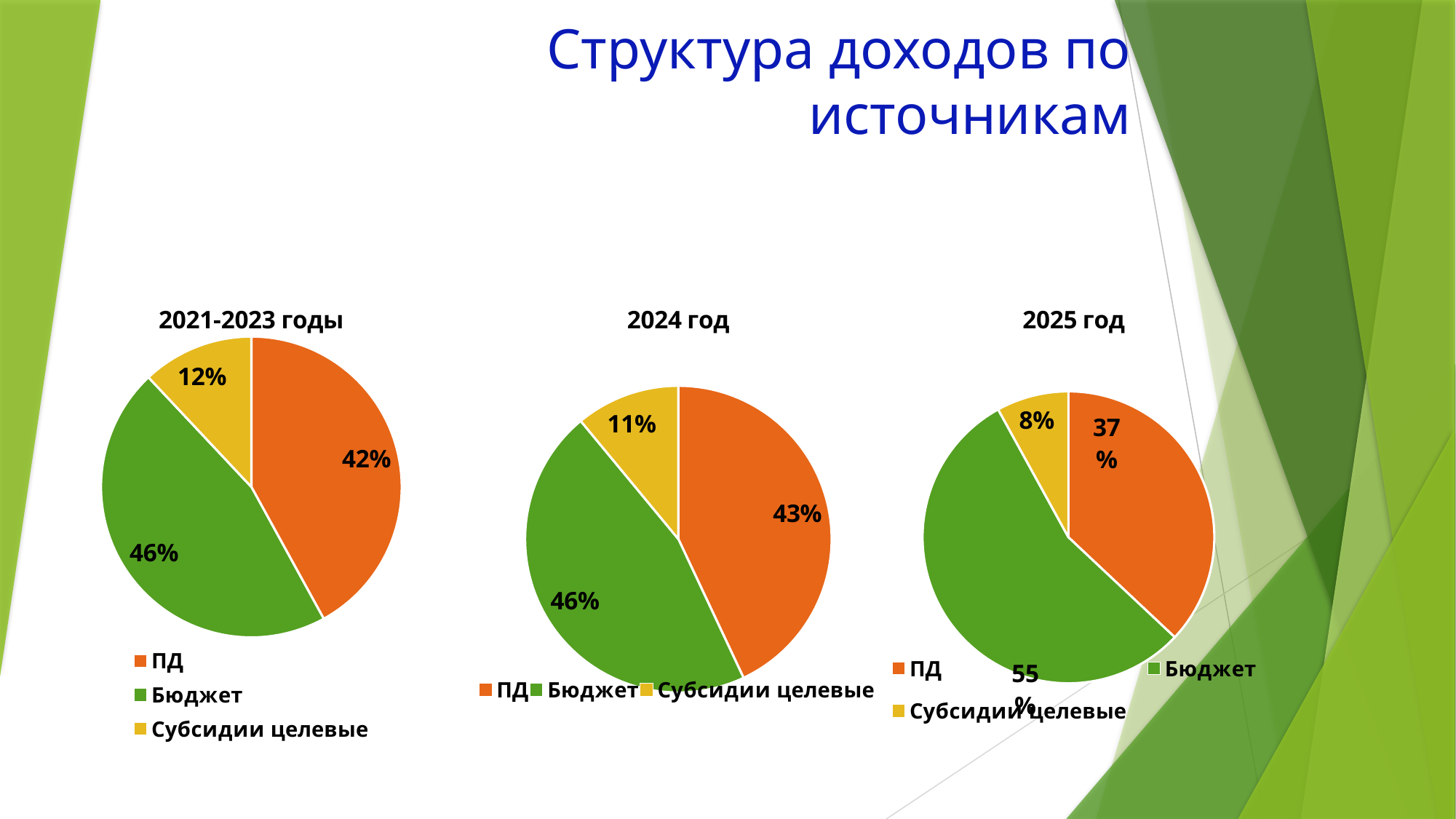
In the "2021-2023 годы" pie chart, what share does ПД have? 42% In the "2024 год" pie chart, what share does Бюджет have? 46% In the "2025 год" pie chart, what share does Бюджет have? 55% How many pie charts are shown on the slide? 3 What type of chart is used for "2024 год"? Pie chart In the "2025 год" pie chart, what is the difference between the Бюджет share and the ПД share? 18% In the "2021-2023 годы" pie chart, what share does Субсидии целевые have? 12% In the "2025 год" pie chart, what share does ПД have? 37% In the "2024 год" pie chart, which category has the largest slice? Бюджет In the "2024 год" pie chart, which is larger: ПД or Субсидии целевые? ПД How many slices does the "2021-2023 годы" pie chart have? 3 In the "2025 год" pie chart, which category has the smallest slice? Субсидии целевые